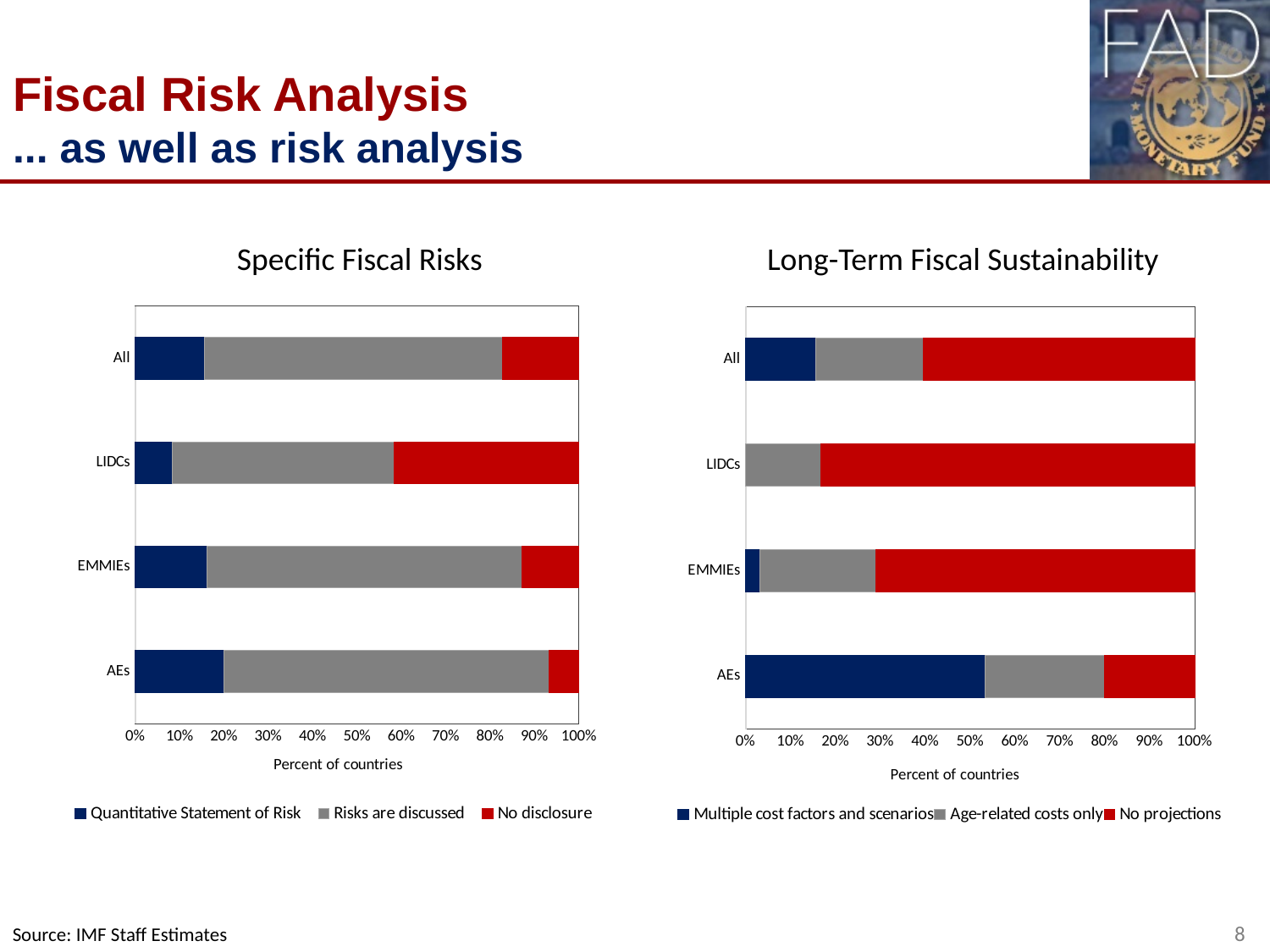
In the Specific Fiscal Risks chart, which category has the largest 'No disclosure' segment? LIDCs How many series does the legend of the Specific Fiscal Risks chart list? 3 Which series is shown in red in the Long-Term Fiscal Sustainability chart? No projections In the Long-Term Fiscal Sustainability chart, is the 'Multiple cost factors and scenarios' value for AEs greater or less than 50%? greater In the Long-Term Fiscal Sustainability chart, is the 'No projections' value for LIDCs greater or less than 80%? greater How many categories are shown on the y axis of the Long-Term Fiscal Sustainability chart? 4 In the Specific Fiscal Risks chart, is the 'Quantitative Statement of Risk' segment larger for AEs or for LIDCs? AEs What kind of chart is the Specific Fiscal Risks chart? Stacked bar chart In the Long-Term Fiscal Sustainability chart, which category has the largest 'Multiple cost factors and scenarios' segment? AEs What is the x-axis title of the Specific Fiscal Risks chart? Percent of countries In the Specific Fiscal Risks chart, which category has the smallest 'No disclosure' segment? AEs